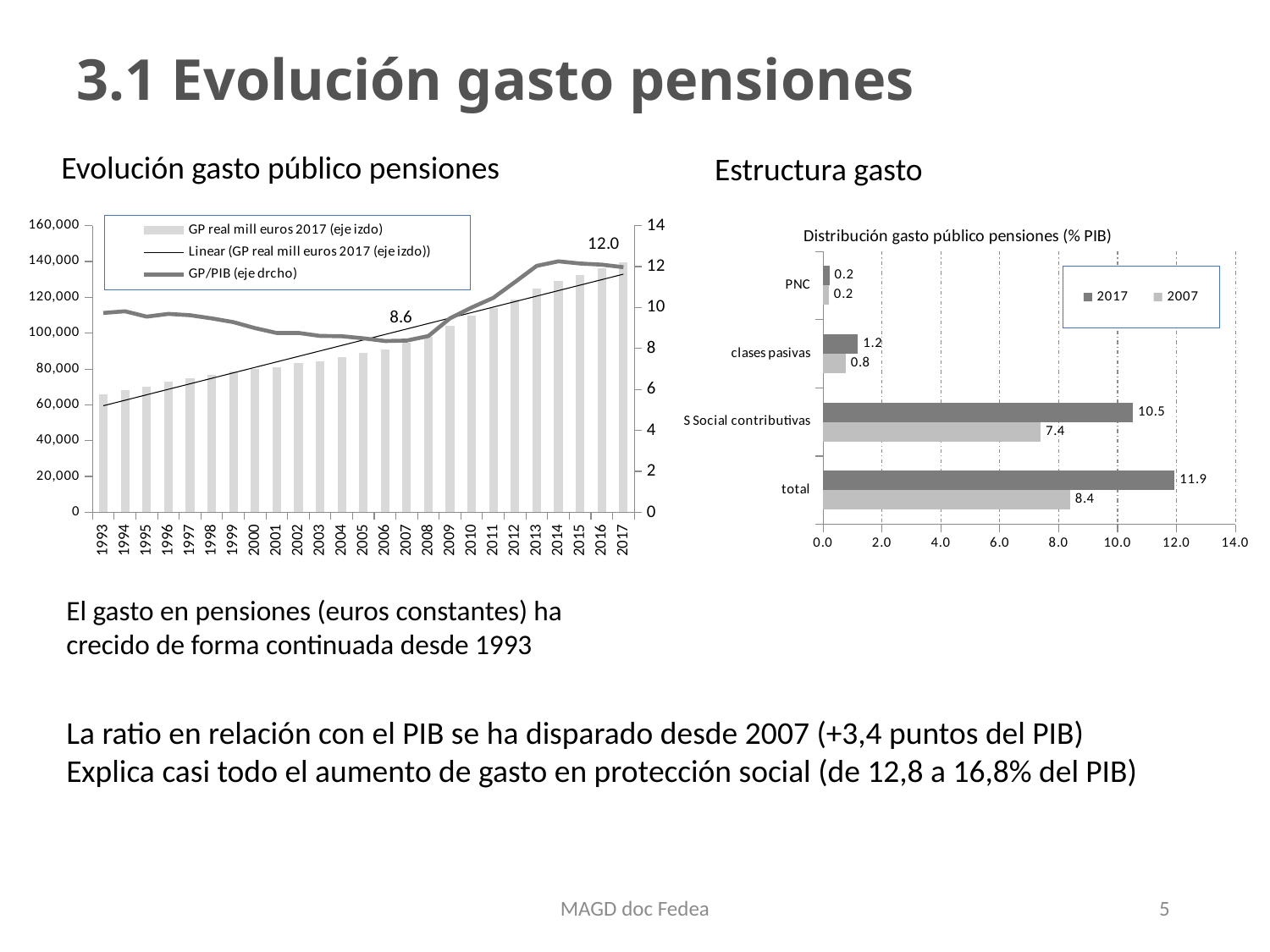
In the 'Distribución gasto público pensiones (% PIB)' chart, what is the difference between the 2017 and 2007 values for 'total'? 3.5 In the 'Evolución gasto público pensiones' chart, what is the labelled GP/PIB value for 2017? 12.0 In the 'Distribución gasto público pensiones (% PIB)' chart, what is the value for 'clases pasivas' in 2017? 1.2 In the 'Distribución gasto público pensiones (% PIB)' chart, is the 2017 value for 'S Social contributivas' larger or smaller than the 2007 value? larger In the 'Evolución gasto público pensiones' chart, what is the labelled GP/PIB value for 2007? 8.6 In the 'Distribución gasto público pensiones (% PIB)' chart, which category has the highest value for 2017? total In the 'Evolución gasto público pensiones' chart, do the GP real mill euros 2017 bars generally rise or fall from 1993 to 2017? rise In the 'Distribución gasto público pensiones (% PIB)' chart, what is the value for 'total' in 2017? 11.9 How many categories are shown in the 'Distribución gasto público pensiones (% PIB)' chart? 4 In the 'Distribución gasto público pensiones (% PIB)' chart, what is the value for 'S Social contributivas' in 2007? 7.4 In the 'Distribución gasto público pensiones (% PIB)' chart, which category has the lowest value for 2007? PNC How many series does the legend of the 'Distribución gasto público pensiones (% PIB)' chart list? 2